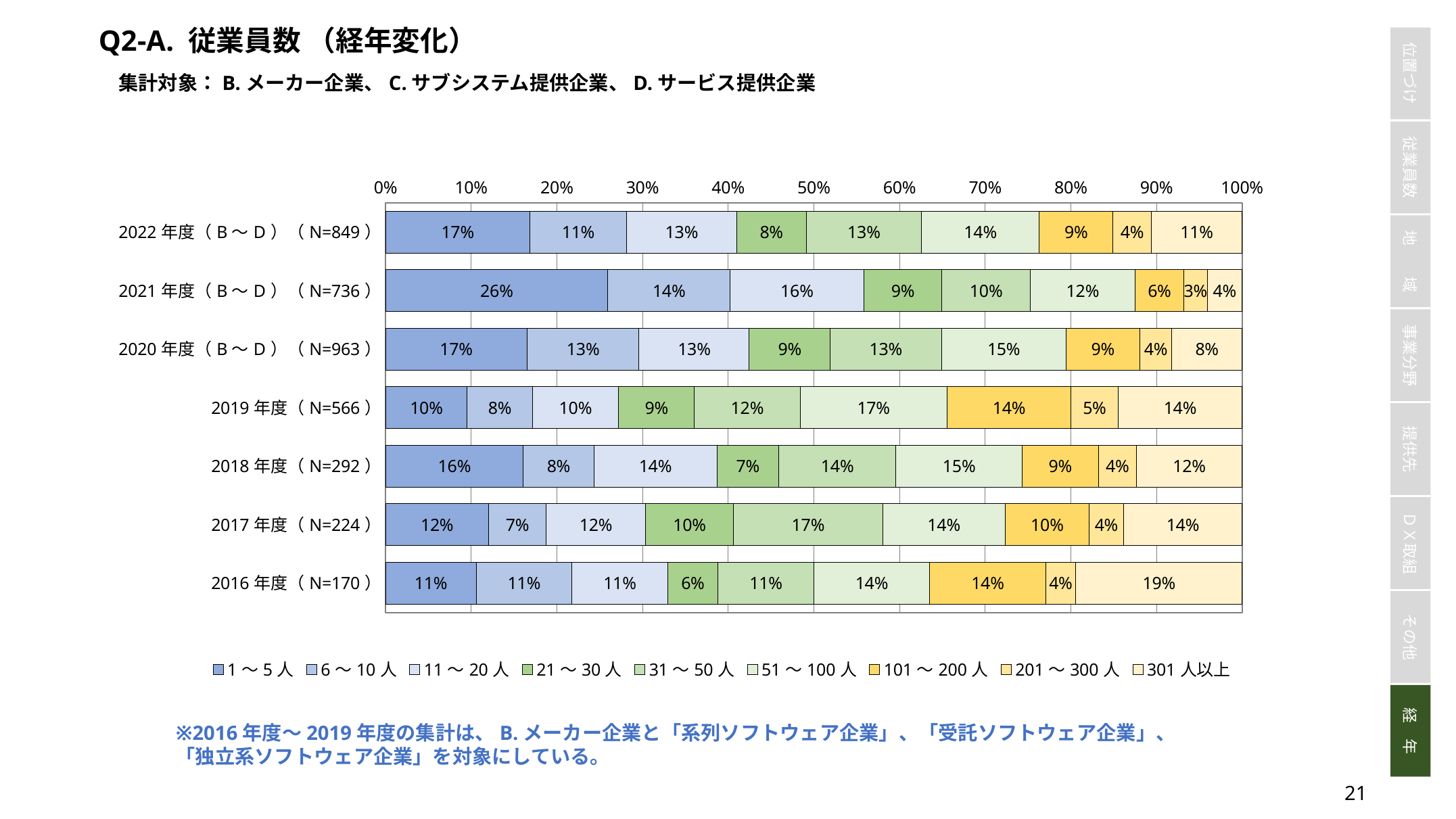
Which year has the highest share in the 1～5人 category? 2021年度 Which year has the lowest share in the 301人以上 category? 2021年度 What is the value for 31～50人 in the 2017年度 (N=224) bar? 17% What kind of chart is shown on the slide? Stacked bar chart What percentage of the 2021年度 (N=736) bar is in the 1～5人 category? 26% What is the value for 301人以上 in the 2016年度 (N=170) bar? 19% Which is larger: the 101～200人 share in 2019年度 or in 2018年度? 2019年度 How many percentage points higher is the 1～5人 share in 2021年度 than in 2022年度? 9 percentage points What is the value for 51～100人 in the 2019年度 (N=566) bar? 17% How many series does the legend list? 9 How many year bars are shown in the chart? 7 What is the N value shown for the 2020年度 bar? 963